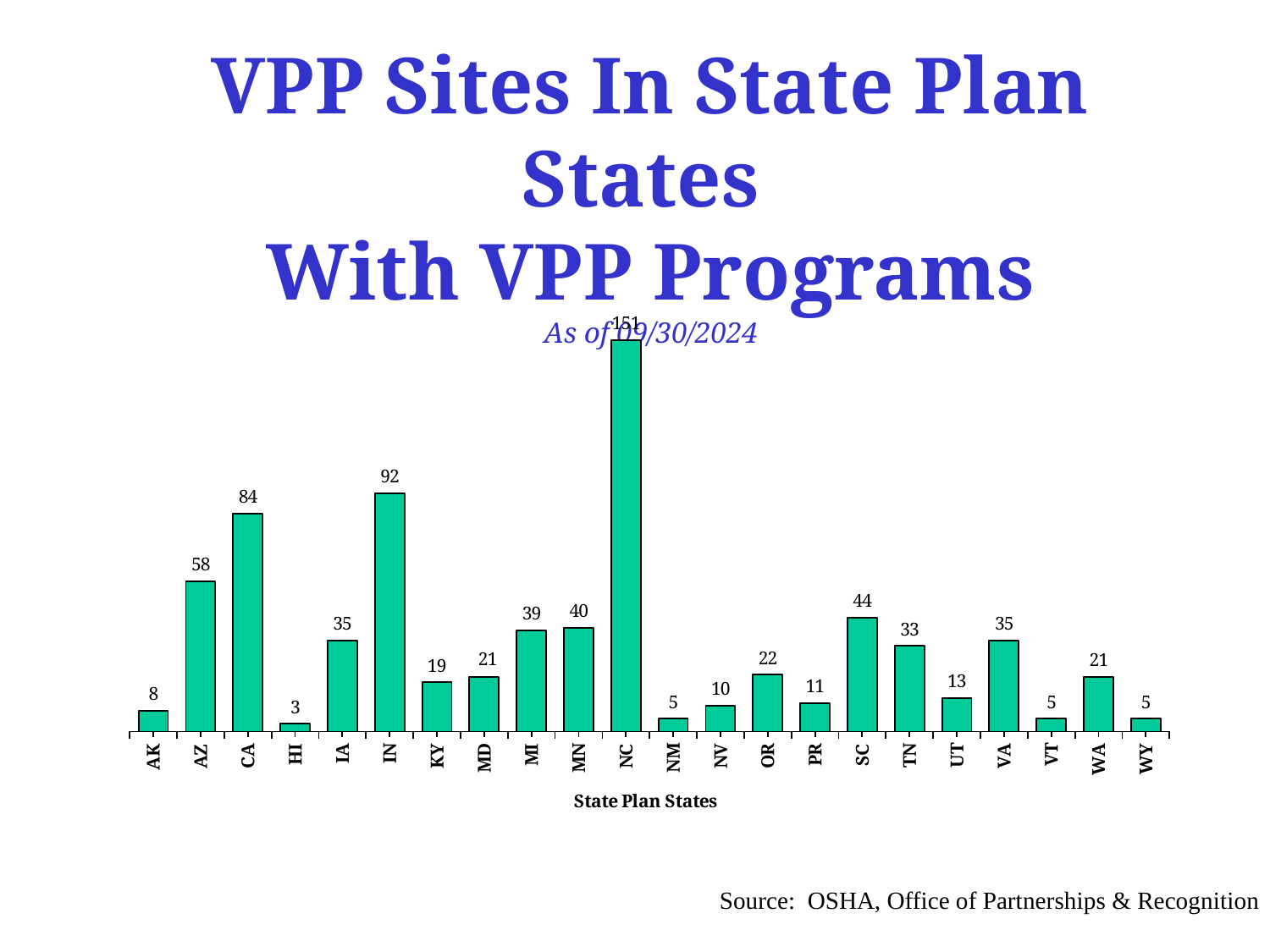
What is the x-axis title of the chart? State Plan States How many states are shown on the x axis? 22 Which state has the lowest number of VPP sites? HI What kind of chart is shown on the slide? Bar chart What is the value for HI? 3 What is the difference between the values for MN and MI? 1 Which state has the highest number of VPP sites? NC What is the value for IN? 92 What is the value for SC? 44 What is the value for CA? 84 Which is larger, the value for TN or the value for OR? TN What is the difference between the values for CA and AZ? 26